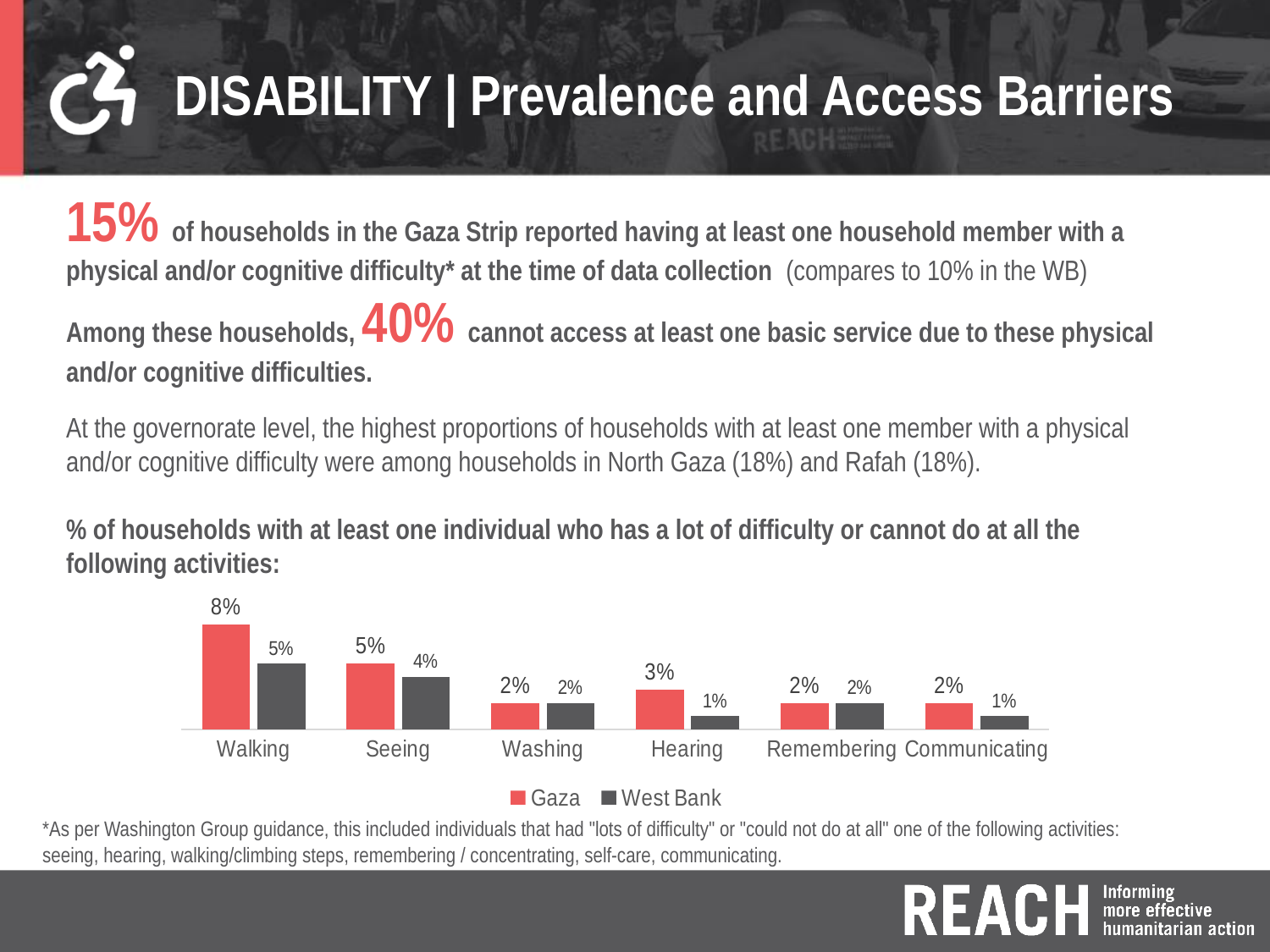
Which category has the lowest value for West Bank? Hearing and Communicating (both 1%) What is the value for West Bank in the Seeing category? 4% Do the Gaza values generally rise or fall from Walking to Communicating along the x axis? Fall How many activity categories are shown on the x axis? 6 What is the difference between the Gaza and West Bank values for Walking? 3% Which category has the highest value for Gaza? Walking What kind of chart is shown on the slide? Bar chart Which is larger, the Gaza value for Seeing or the Gaza value for Hearing? Seeing How many series does the legend list? 2 What is the value for West Bank in the Hearing category? 1% Which series is shown in red in the legend? Gaza What is the value for Gaza in the Walking category? 8%